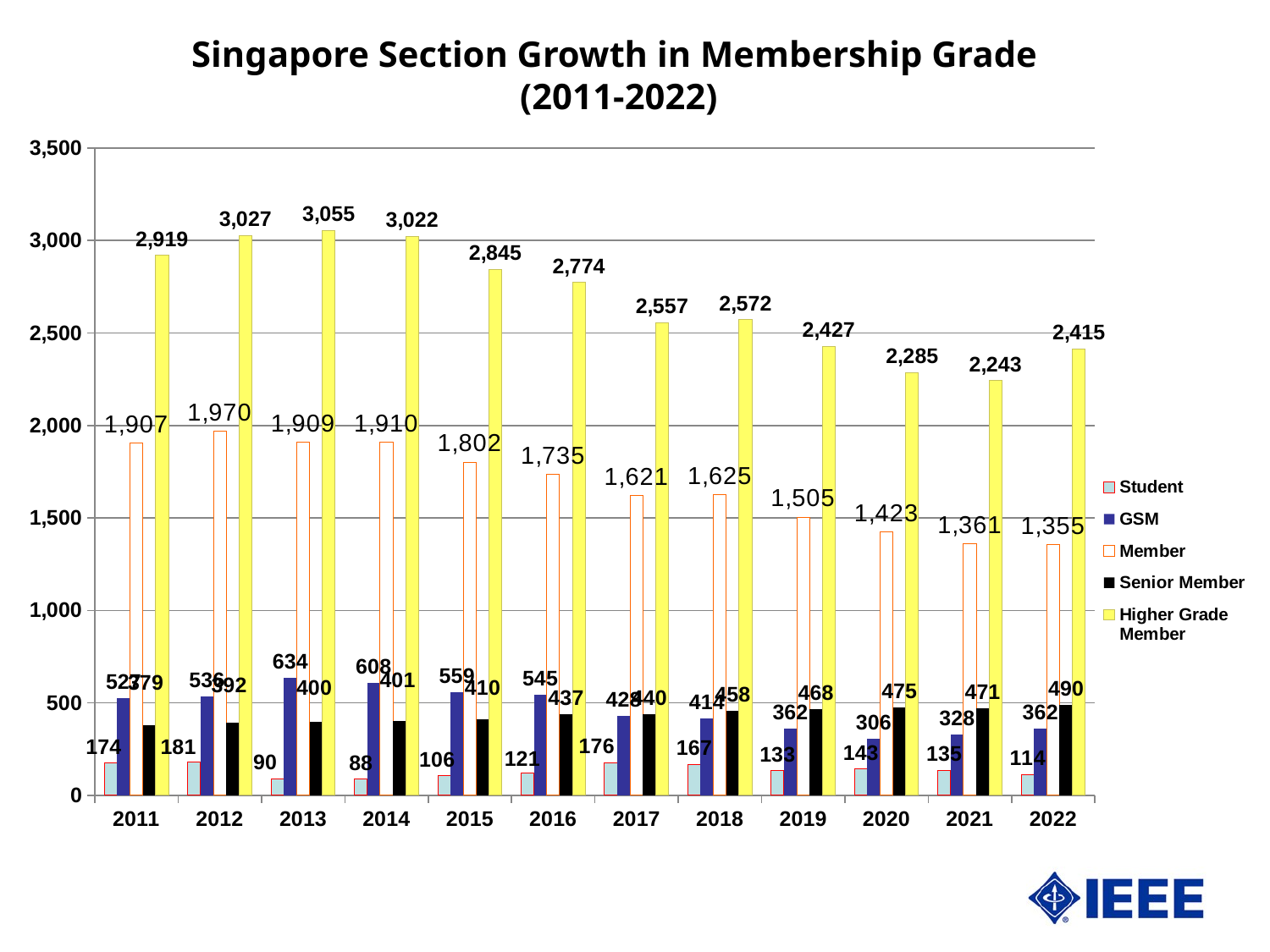
How many years are shown along the x axis? 12 In which year is the Higher Grade Member value highest? 2013 What is the Higher Grade Member value for 2013? 3,055 Does the Member series generally rise or fall from 2011 to 2022? fall In 2022, which is larger: the Senior Member value or the GSM value? Senior Member What is the Member value for 2022? 1,355 How many series does the legend list? 5 What kind of chart is shown on the slide? bar chart What is the difference between the Higher Grade Member values for 2011 and 2022? 504 What is the GSM value for 2013? 634 In which year is the Student value lowest? 2014 What is the title of the chart? Singapore Section Growth in Membership Grade (2011-2022)